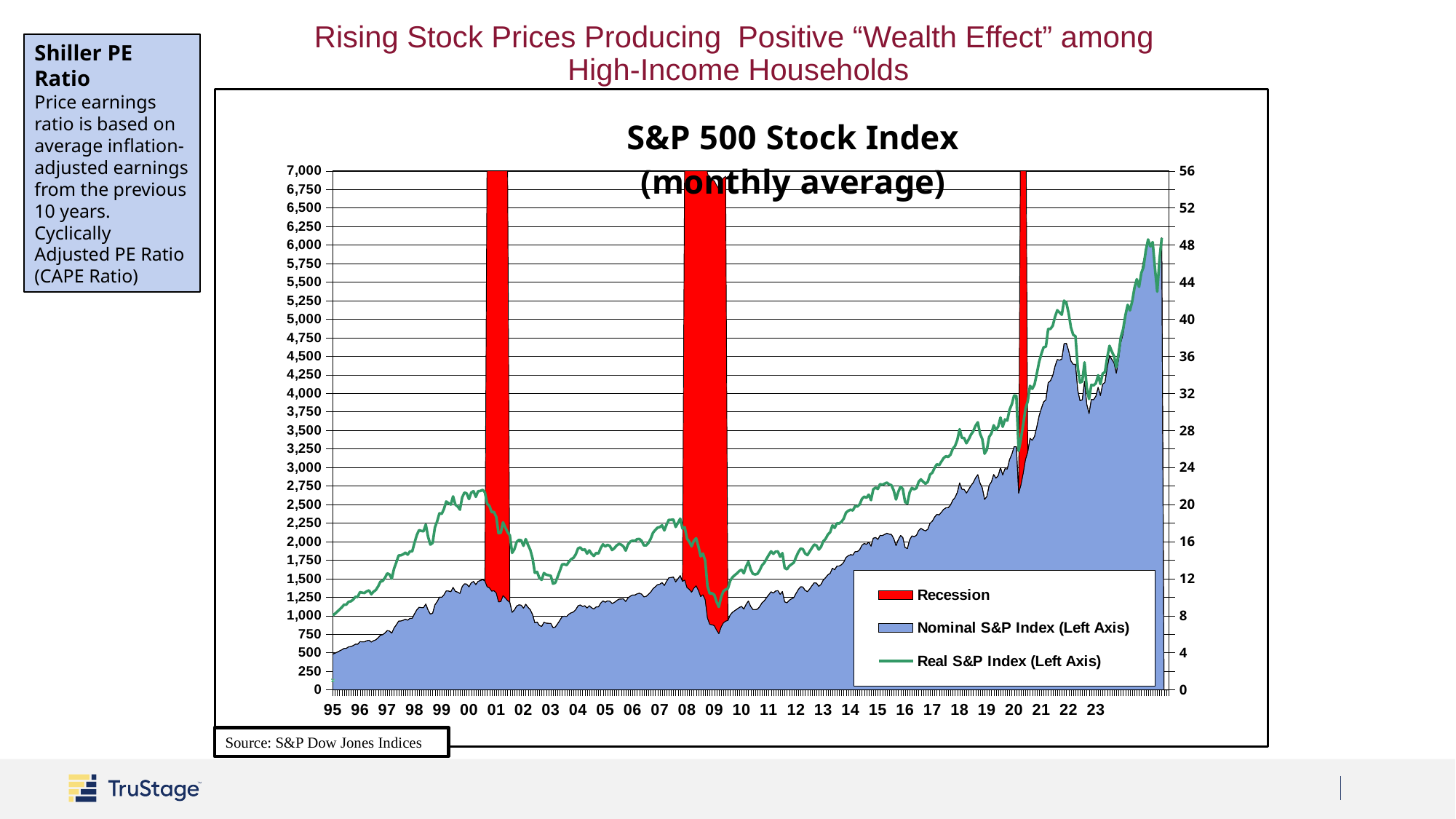
Is the Nominal S&P Index at the start of the series (1995) greater or less than 1,000? less How many recession periods are shaded on the chart? 3 What kind of chart is used to show the S&P 500 Stock Index? area and line chart Is the Real S&P Index at its 2000 peak greater or less than 2,000? greater Is the Nominal S&P Index at its 2009 low greater or less than 1,000? less In 2000, which is higher, the Real S&P Index or the Nominal S&P Index? Real S&P Index What is the title of the chart? S&P 500 Stock Index (monthly average) How many entries does the chart's legend list? 3 Does the Nominal S&P Index generally rise or fall from 95 to 23? rise What colour is used to mark recessions on the chart? red Does the Real S&P Index rise or fall between 2000 and 2003? fall